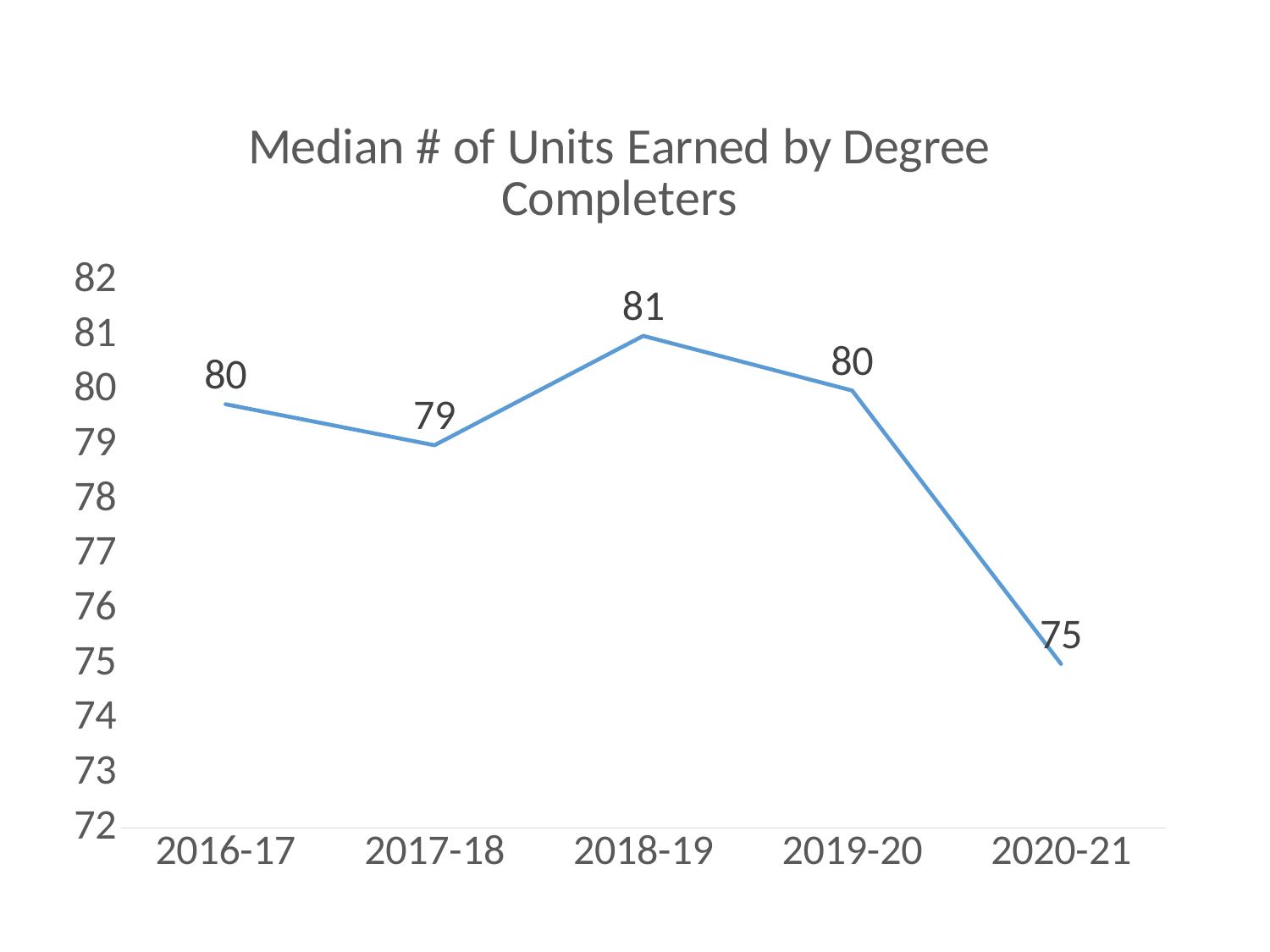
Which is larger, the value for 2016-17 or the value for 2020-21? 2016-17 What is the difference between the values for 2018-19 and 2017-18? 2 What is the median number of units earned by degree completers in 2018-19? 81 What is the value for 2020-21? 75 What is the value for 2017-18? 79 What is the title of the chart? Median # of Units Earned by Degree Completers Is the value for 2020-21 greater or less than 78? less What is the difference between the values for 2019-20 and 2020-21? 5 How many years are plotted on the chart? 5 Which year has the lowest median number of units earned? 2020-21 What kind of chart is shown on the slide? line chart Which year has the highest median number of units earned? 2018-19